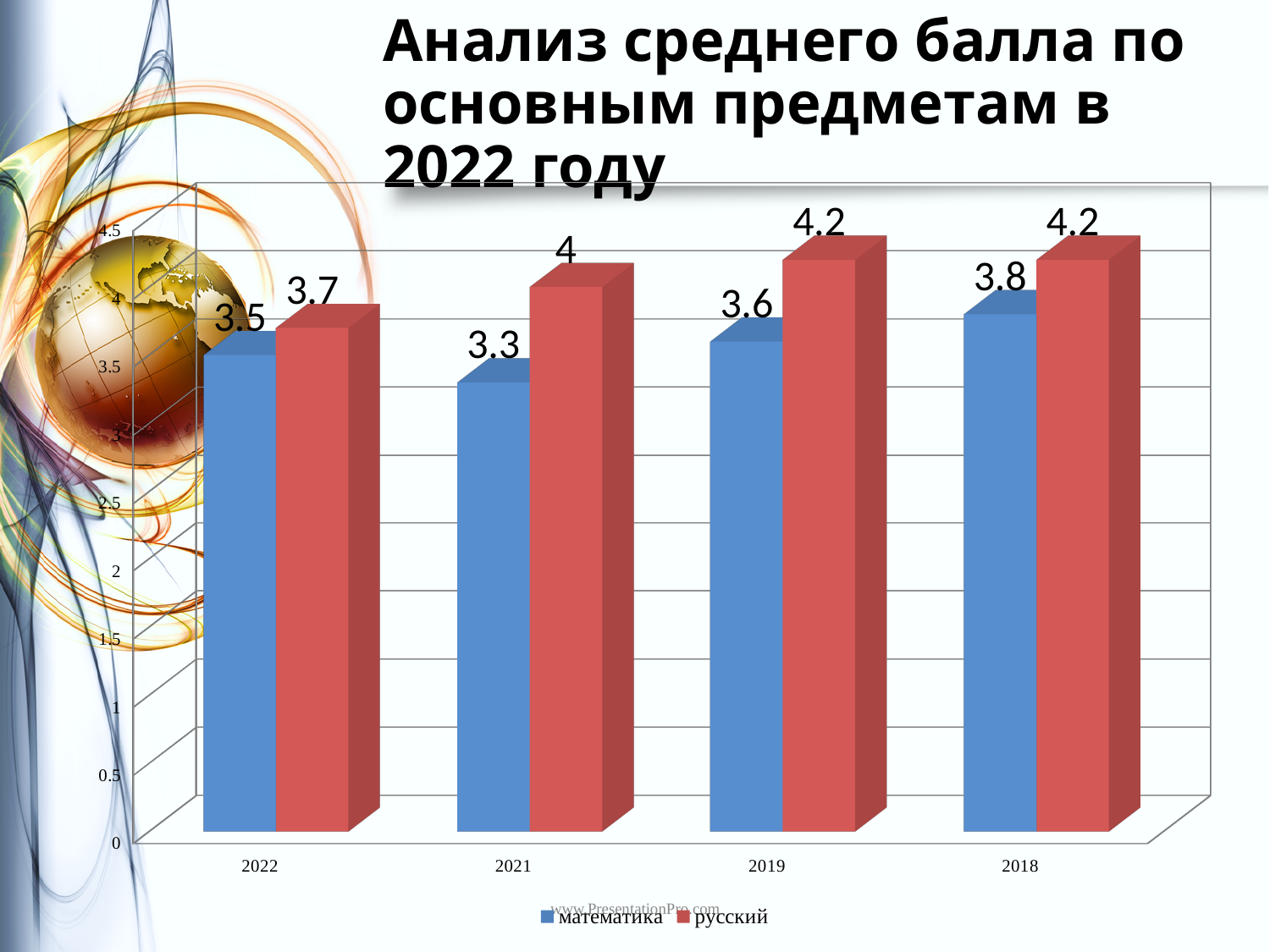
Which year has the lowest value for математика? 2021 How many years are shown on the x axis? 4 What is the value for математика in 2018? 3.8 What kind of chart is shown on the slide? bar chart Which year has the highest value for математика? 2018 What is the difference between русский and математика in 2021? 0.7 What is the value for математика in 2022? 3.5 What is the value for русский in 2021? 4 What is the value for русский in 2019? 4.2 How many series does the legend list? 2 Which year has the lowest value for русский? 2022 Which is larger in 2022, математика or русский? русский